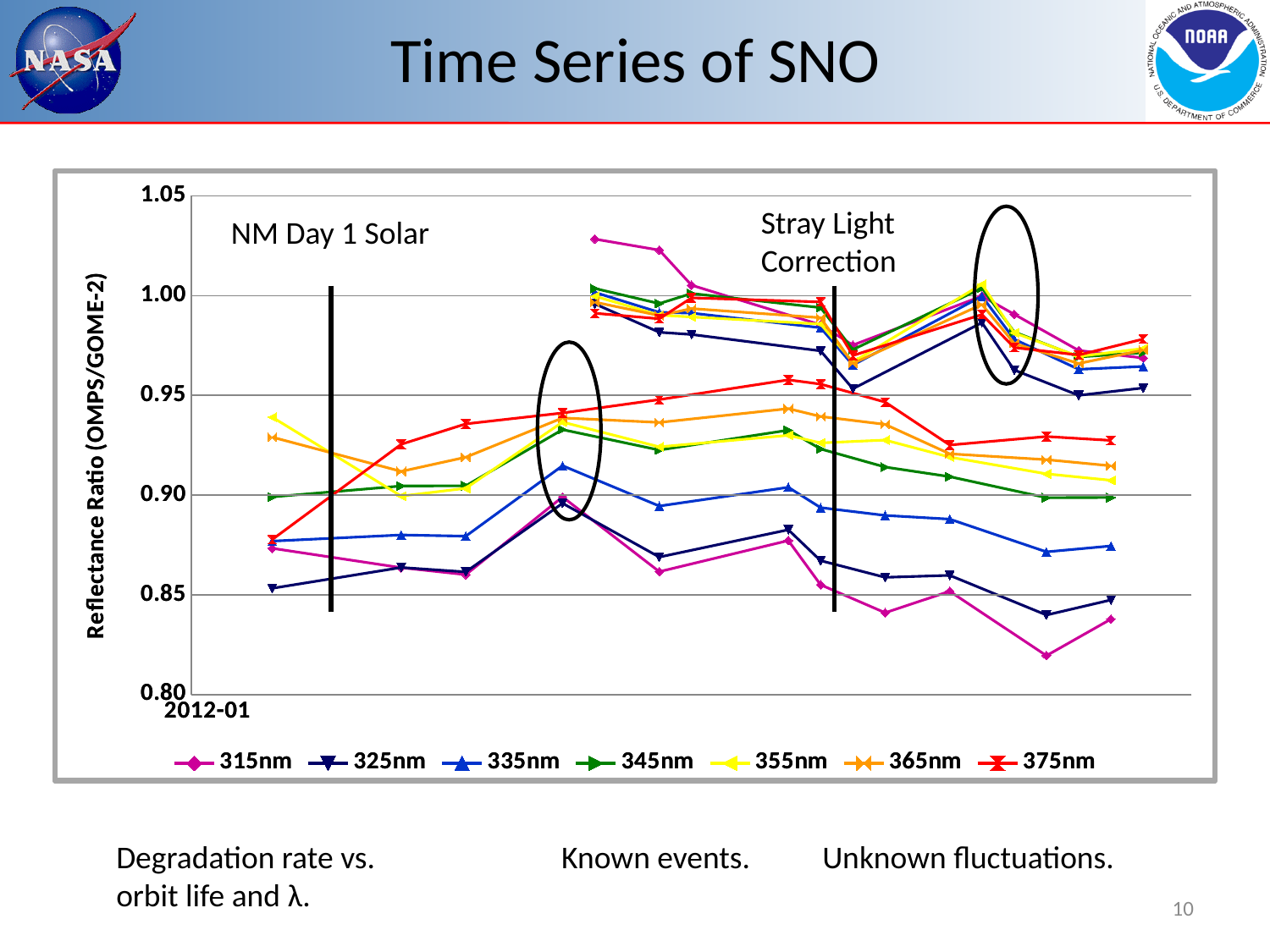
How many series does the legend list? 7 Which wavelength series is drawn in red? 375nm Does the 315nm series rise or fall overall from its first point to its last point? fall At the first plotted point, which series has the higher value, 355nm or 325nm? 355nm Is the last plotted value of the 375nm series greater or less than 0.90? greater What is the label of the y axis? Reflectance Ratio (OMPS/GOME-2) What kind of chart is shown on the slide? line chart Is the first plotted value of the 355nm series greater or less than 0.90? greater